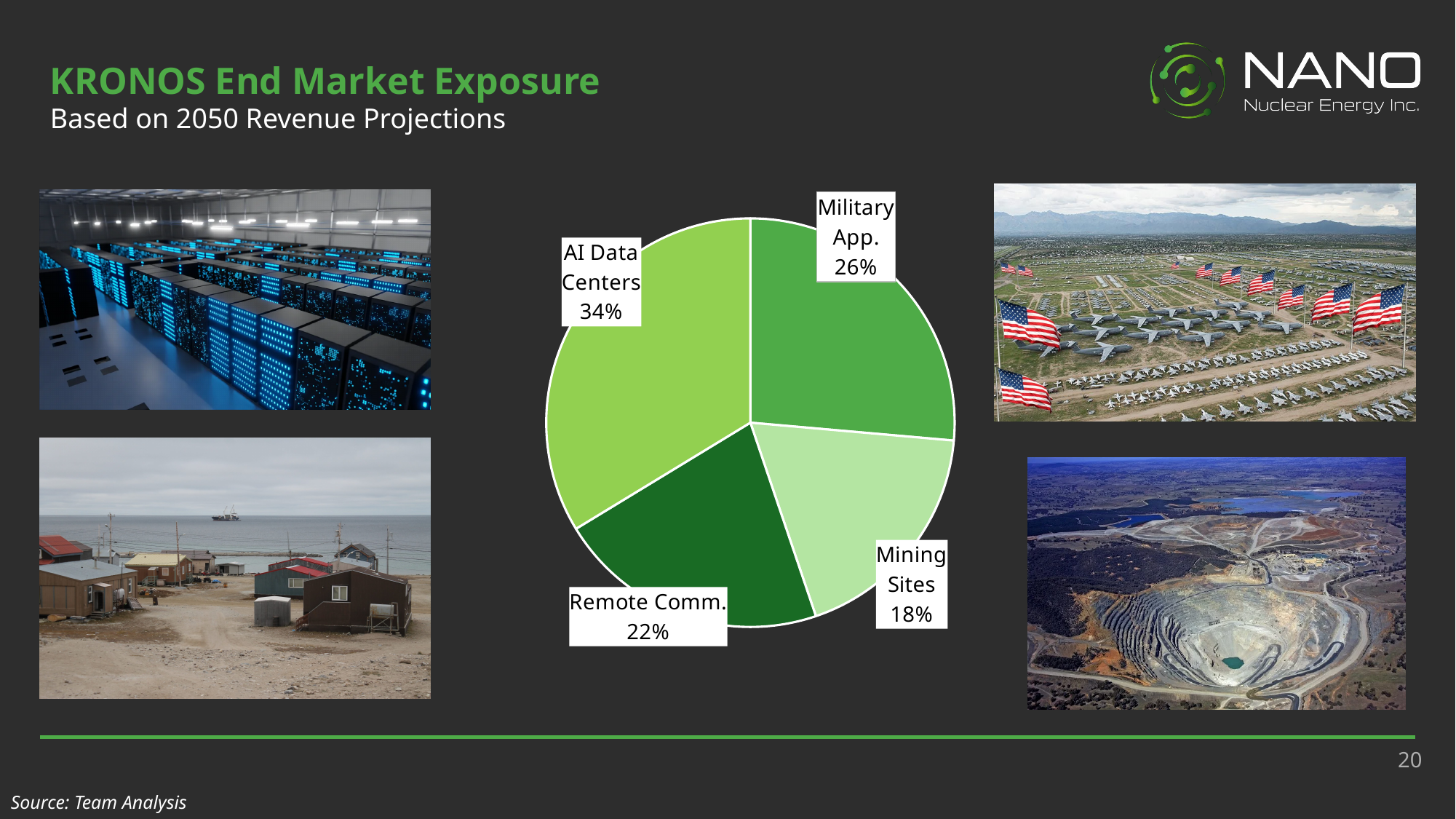
Which end market has the smallest share in the pie chart? Mining Sites What share of the pie chart is Mining Sites? 18% What is the difference in percentage points between Military App. and Remote Comm.? 4 Which end market has the largest share in the pie chart? AI Data Centers What share of the pie chart is Remote Comm.? 22% What share of the pie chart is Military App.? 26% Which has a larger share, Remote Comm. or Mining Sites? Remote Comm. How many end market categories are shown in the pie chart? 4 What is the title of the slide containing the chart? KRONOS End Market Exposure What kind of chart is shown on the slide? Pie chart What is the difference in percentage points between AI Data Centers and Mining Sites? 16 What share of the pie chart is AI Data Centers? 34%